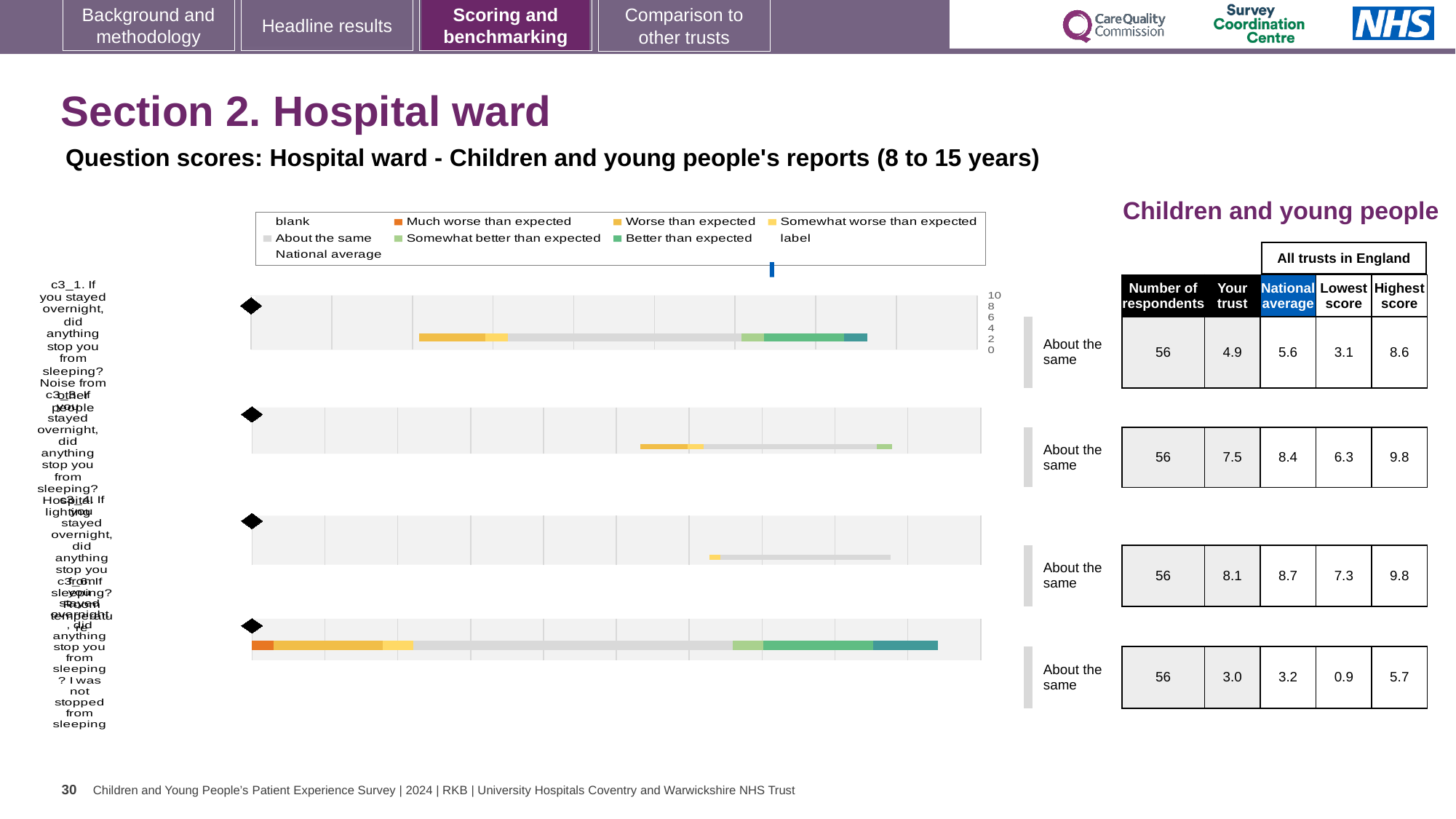
What benchmark label is printed to the right of each of the four bars? About the same How many entries does the chart legend list? 9 How many horizontal bars are plotted in the chart? 4 Does the top bar (c3_1) contain an orange 'Much worse than expected' segment? No Which legend entry is shown in grey? About the same Which colour does the legend use for 'Much worse than expected'? orange Which of the four bars contains the most coloured segments? the bottom bar (c3_6) What kind of chart is shown on the slide? bar chart